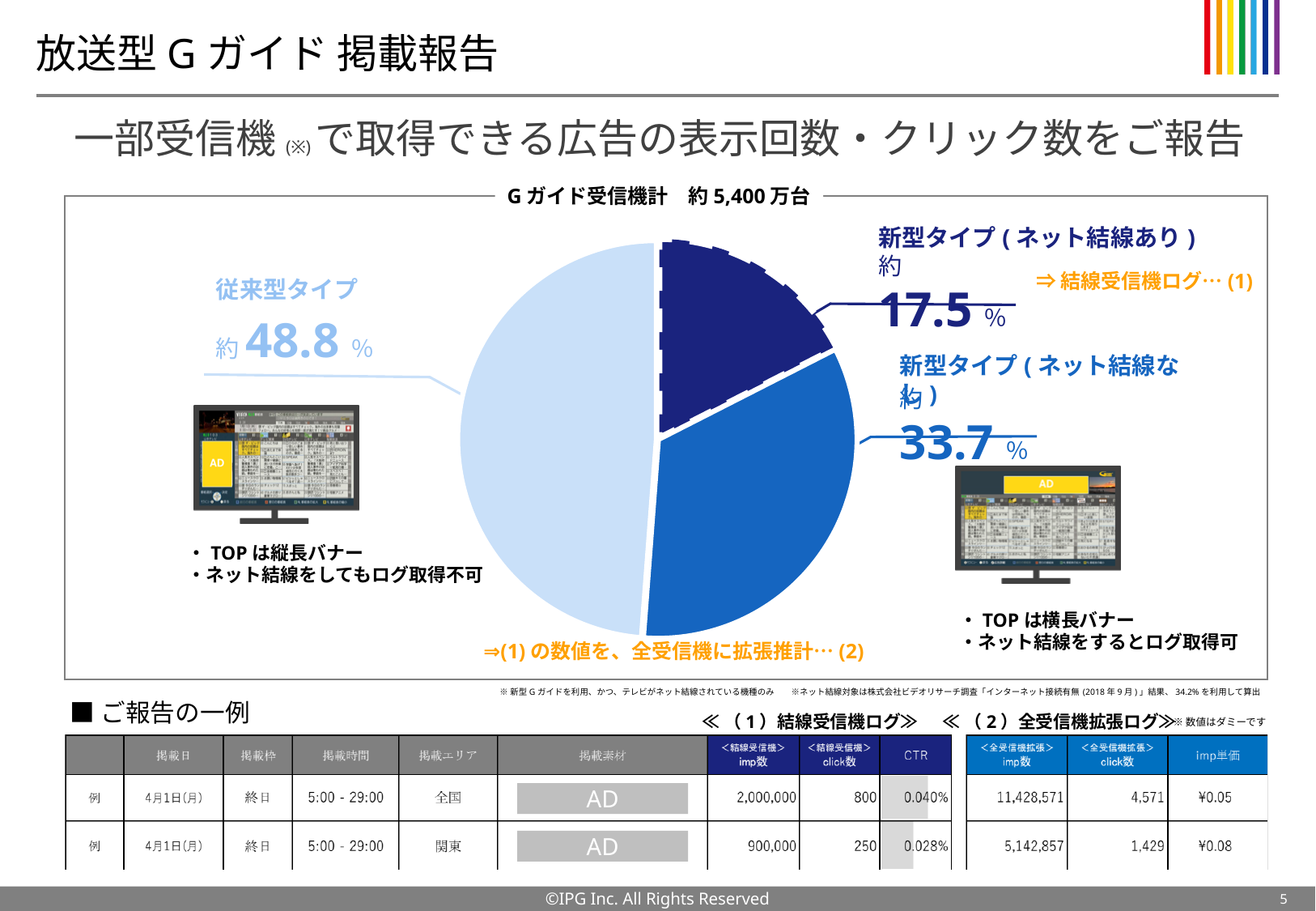
By how many percentage points does 新型タイプ(ネット結線なし) exceed 新型タイプ(ネット結線あり) in the pie chart? 16.2 percentage points What kind of chart is shown on the slide? Pie chart Which slice of the pie chart is the largest? 従来型タイプ How many slices does the pie chart have? 3 In the pie chart, which is larger: 新型タイプ(ネット結線あり) or 新型タイプ(ネット結線なし)? 新型タイプ(ネット結線なし) What is the title shown above the pie chart? Gガイド受信機計 約5,400万台 Which slice of the pie chart is the smallest? 新型タイプ(ネット結線あり) By how many percentage points does 従来型タイプ exceed 新型タイプ(ネット結線なし) in the pie chart? 15.1 percentage points In the pie chart, what share is shown for 新型タイプ(ネット結線なし)? 33.7% What is the combined share of the two 新型タイプ slices in the pie chart? 51.2% In the pie chart, what share is shown for 新型タイプ(ネット結線あり)? 17.5% In the pie chart, what share is shown for 従来型タイプ? 48.8%